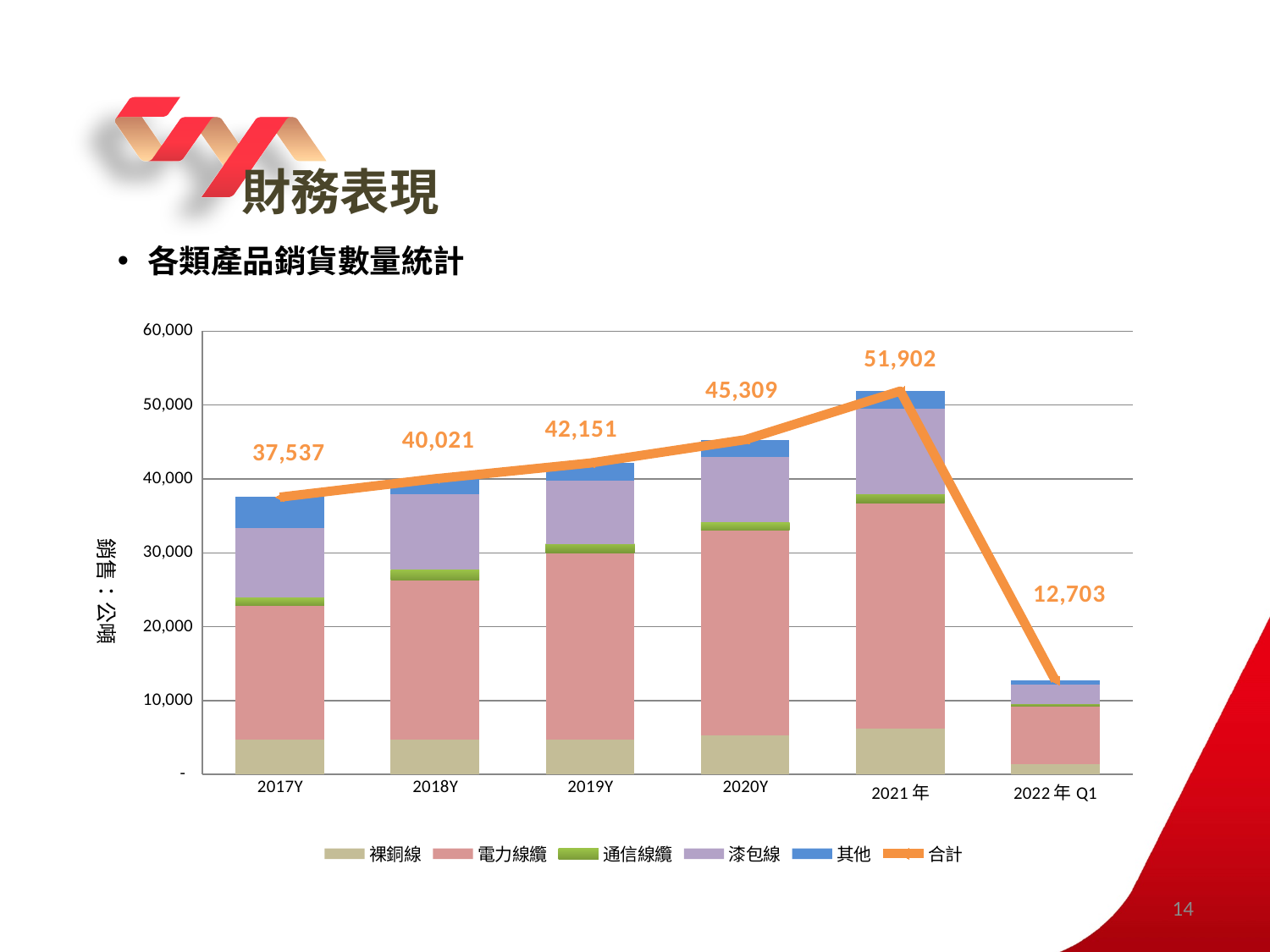
Which is larger, the total for 2018Y or the total for 2019Y? 2019Y Does the total (合計) rise or fall from 2017Y to 2021年? Rise Which period has the lowest total (合計) value? 2022年 Q1 What is the total (合計) value shown for 2020Y? 45,309 How many series does the legend list? 6 Which period has the highest total (合計) value? 2021年 What is the total (合計) value shown for 2017Y? 37,537 What kind of chart is shown on the slide? Stacked bar chart with a line What is the difference between the total for 2021年 and the total for 2020Y? 6,593 How many periods are shown on the x axis? 6 What is the total (合計) value shown for 2022年 Q1? 12,703